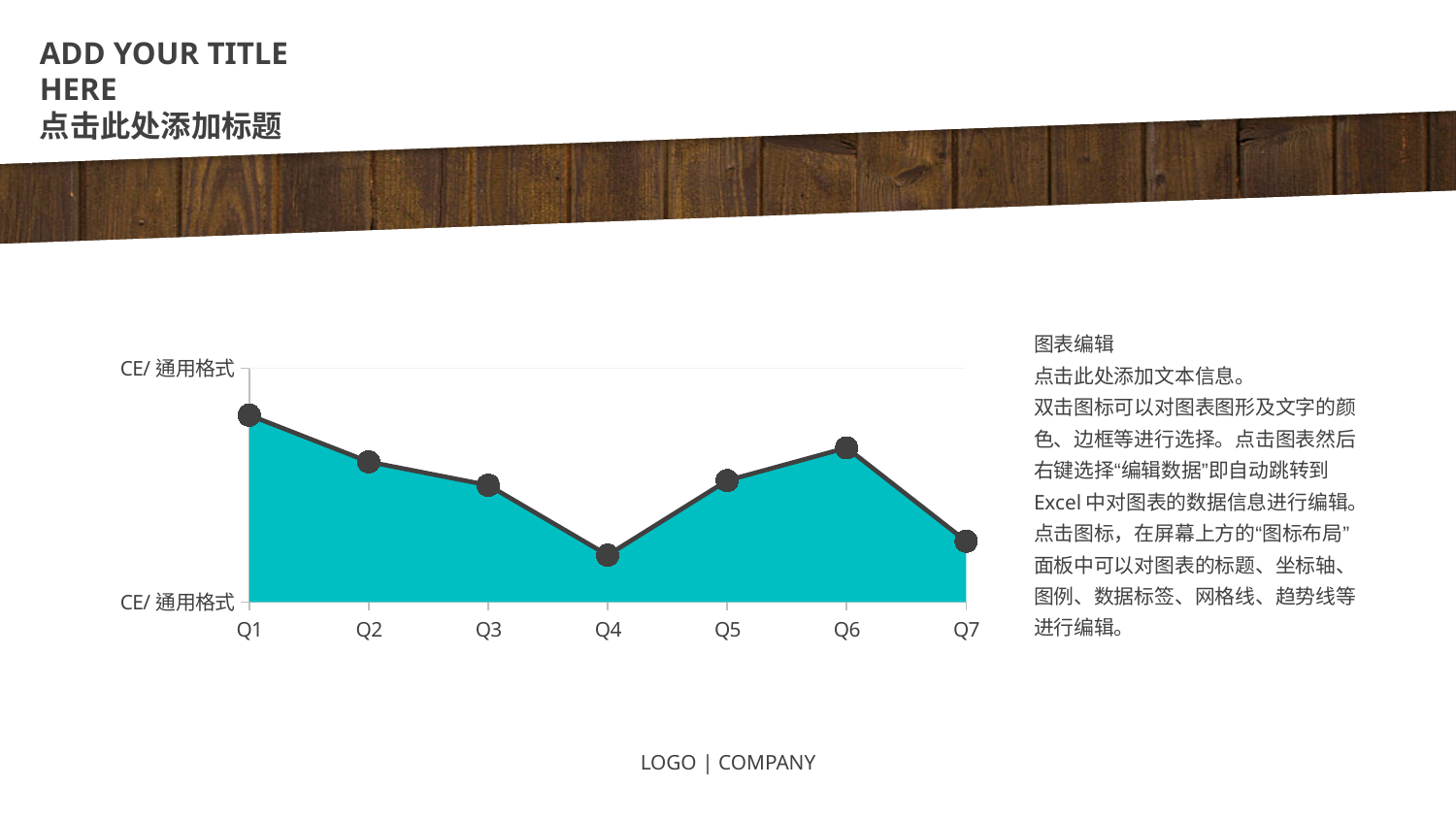
How many data points are plotted along the x axis? 7 What kind of chart is shown on the slide? Area chart Which quarter has the highest value? Q1 Which is larger, the value for Q5 or the value for Q6? Q6 Do the values rise or fall from Q1 to Q4? Fall Do the values rise or fall from Q4 to Q6? Rise Which is larger, the value for Q2 or the value for Q3? Q2 Which is larger, the value for Q1 or the value for Q6? Q1 What is the first category label on the x axis? Q1 What colour is the filled area under the line? Teal Which quarter has the lowest value? Q4